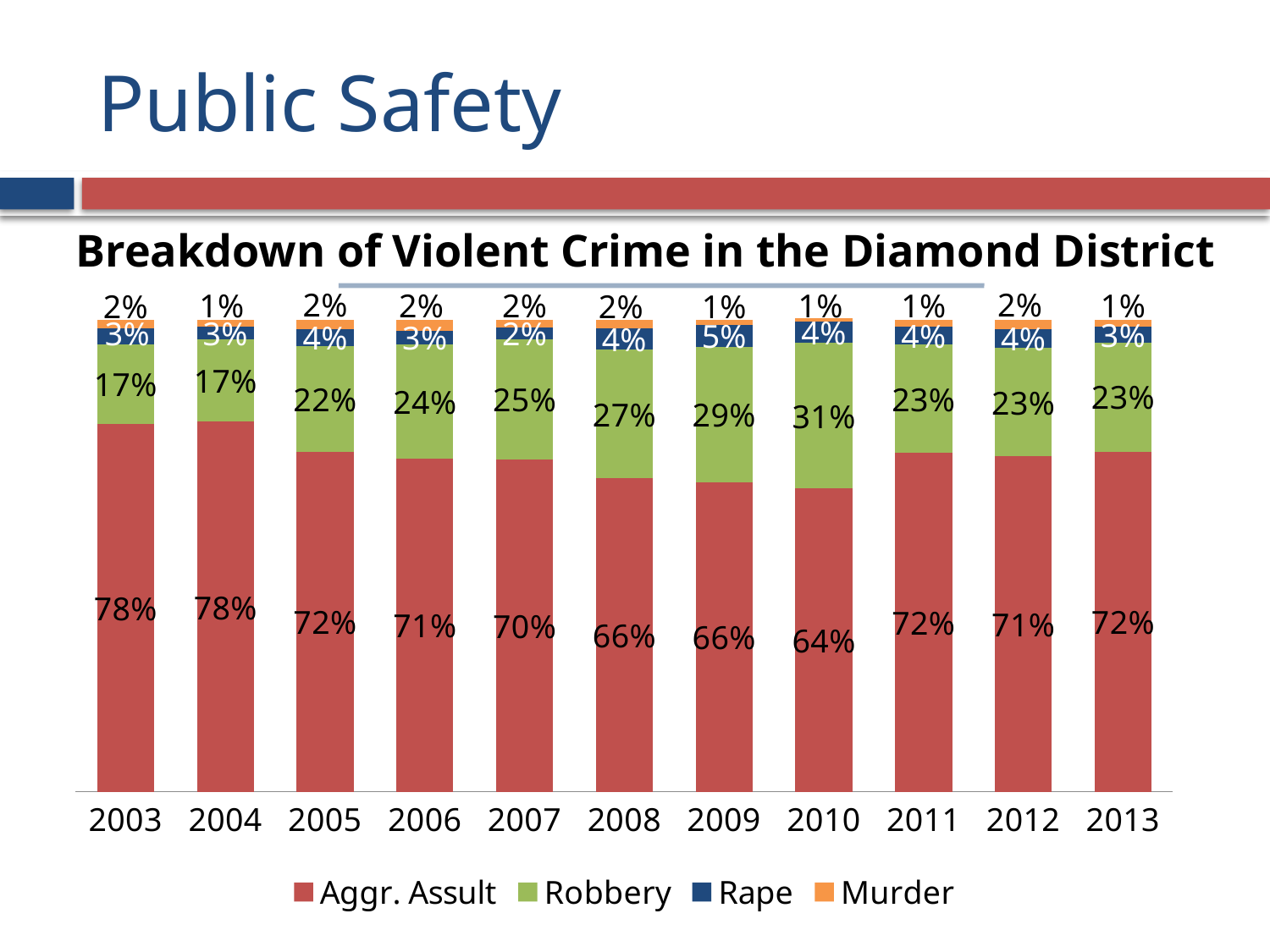
What is the difference between the Aggr. Assult share in 2003 and in 2010? 14% What kind of chart is shown on the slide? Stacked bar chart What percentage of violent crime was Aggr. Assult in 2003? 78% In which year was the Robbery share highest? 2010 What is the title of the chart? Breakdown of Violent Crime in the Diamond District How many years are shown on the x axis? 11 How many series does the legend list? 4 Did the Robbery share rise or fall from 2003 to 2010? Rise Which year had a larger Robbery share, 2005 or 2008? 2008 What percentage of violent crime was Rape in 2009? 5% In which year was the Aggr. Assult share lowest? 2010 What percentage of violent crime was Robbery in 2010? 31%